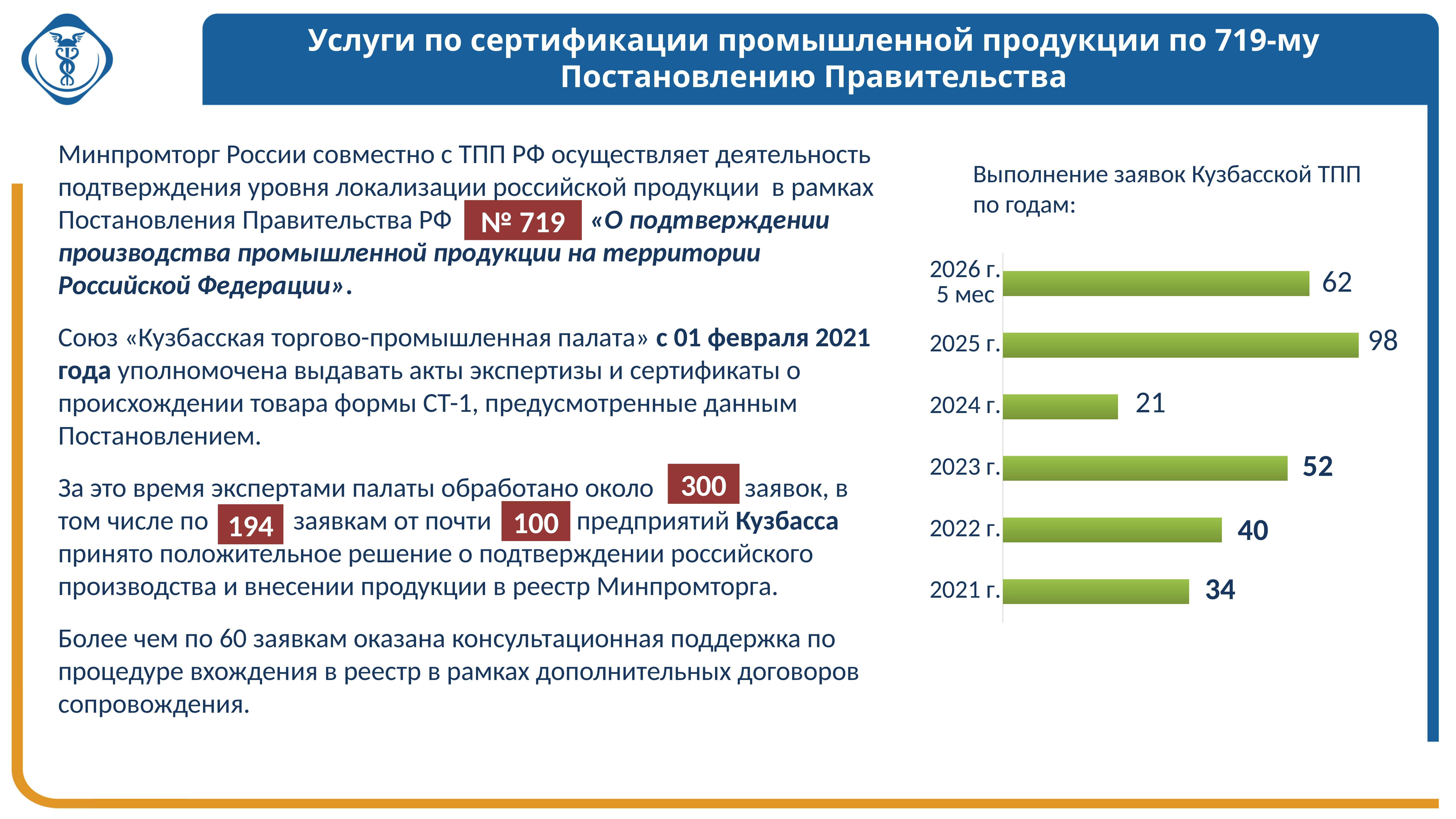
What is the difference between the values for 2025 г. and 2024 г.? 77 What colour are the bars in the chart? Green What kind of chart is shown on the slide? Bar chart Which year has the highest value in the chart? 2025 г. What is the title of the chart? Выполнение заявок Кузбасской ТПП по годам: Which is larger, the value for 2022 г. or the value for 2021 г.? 2022 г. What is the difference between the values for 2023 г. and 2022 г.? 12 What is the value for 2025 г. in the chart? 98 How many categories (years) are shown in the chart? 6 Which year has the lowest value in the chart? 2024 г. What is the value for 2026 г. 5 мес in the chart? 62 What is the value for 2021 г. in the chart? 34